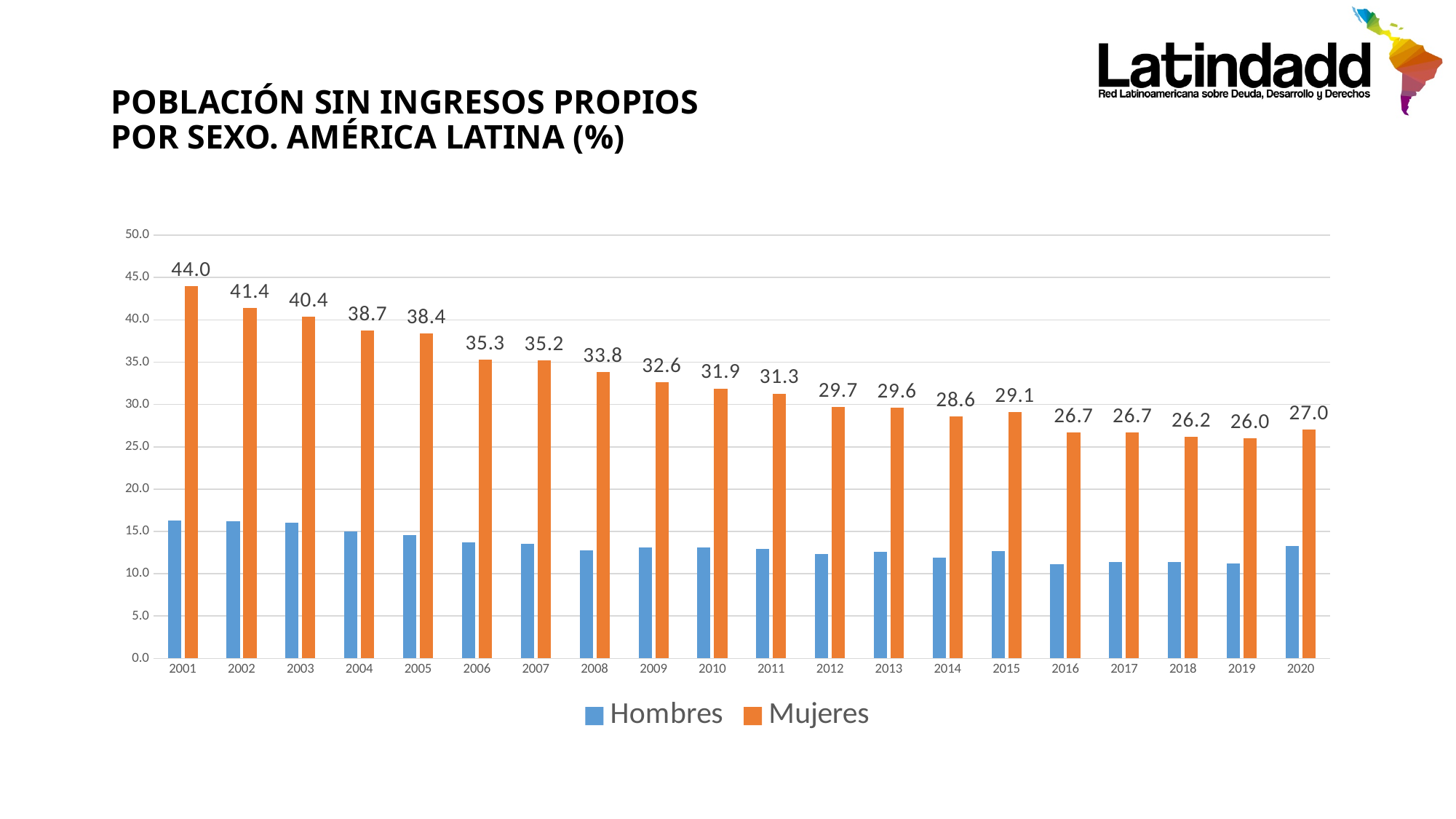
In which year is the Mujeres value lowest? 2019 Is the value for Hombres in 2001 greater or less than 15.0? greater Is the value for Hombres in 2016 greater or less than 15.0? less What is the value for Mujeres in 2010? 31.9 What is the difference between the Mujeres values in 2001 and 2020? 17.0 How many series does the legend list? 2 What kind of chart is shown? Bar chart In which year is the Mujeres value highest? 2001 What is the value for Mujeres in 2001? 44.0 How many years are shown on the x axis? 20 What is the value for Mujeres in 2020? 27.0 Which is larger in 2005, the value for Hombres or for Mujeres? Mujeres